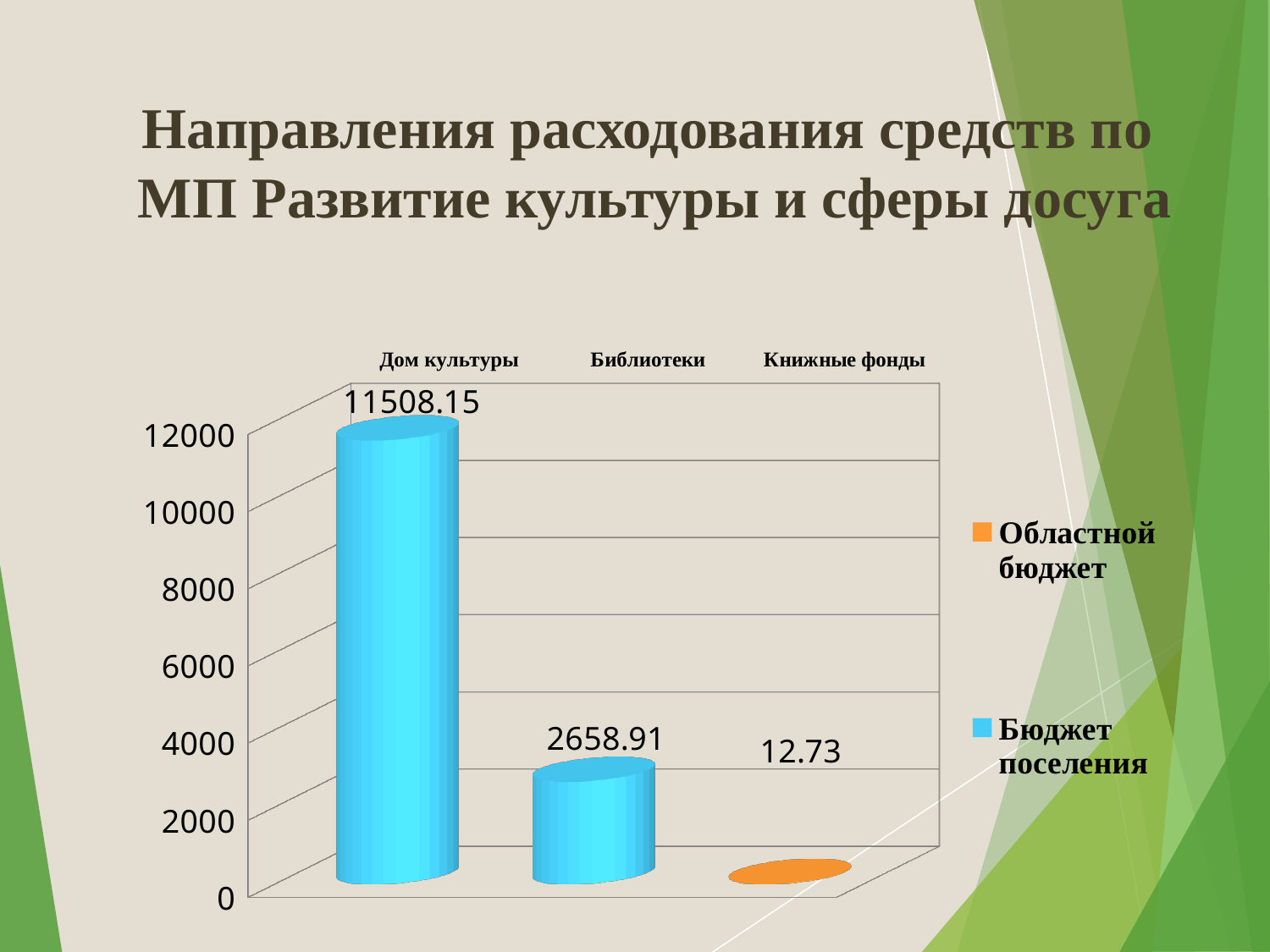
Which category has the lowest value? Книжные фонды Is the value for Библиотеки greater or less than 4000? less Which category has the highest value? Дом культуры What is the difference between the values for Дом культуры and Библиотеки? 8849.24 How many series does the legend list? 2 What is the value shown for Библиотеки? 2658.91 What is the value shown for Дом культуры? 11508.15 Which legend series is shown in orange? Областной бюджет Which is larger, the value for Библиотеки or the value for Книжные фонды? Библиотеки How many categories are shown on the chart? 3 What is the value shown for Книжные фонды? 12.73 What kind of chart is shown on the slide? bar chart